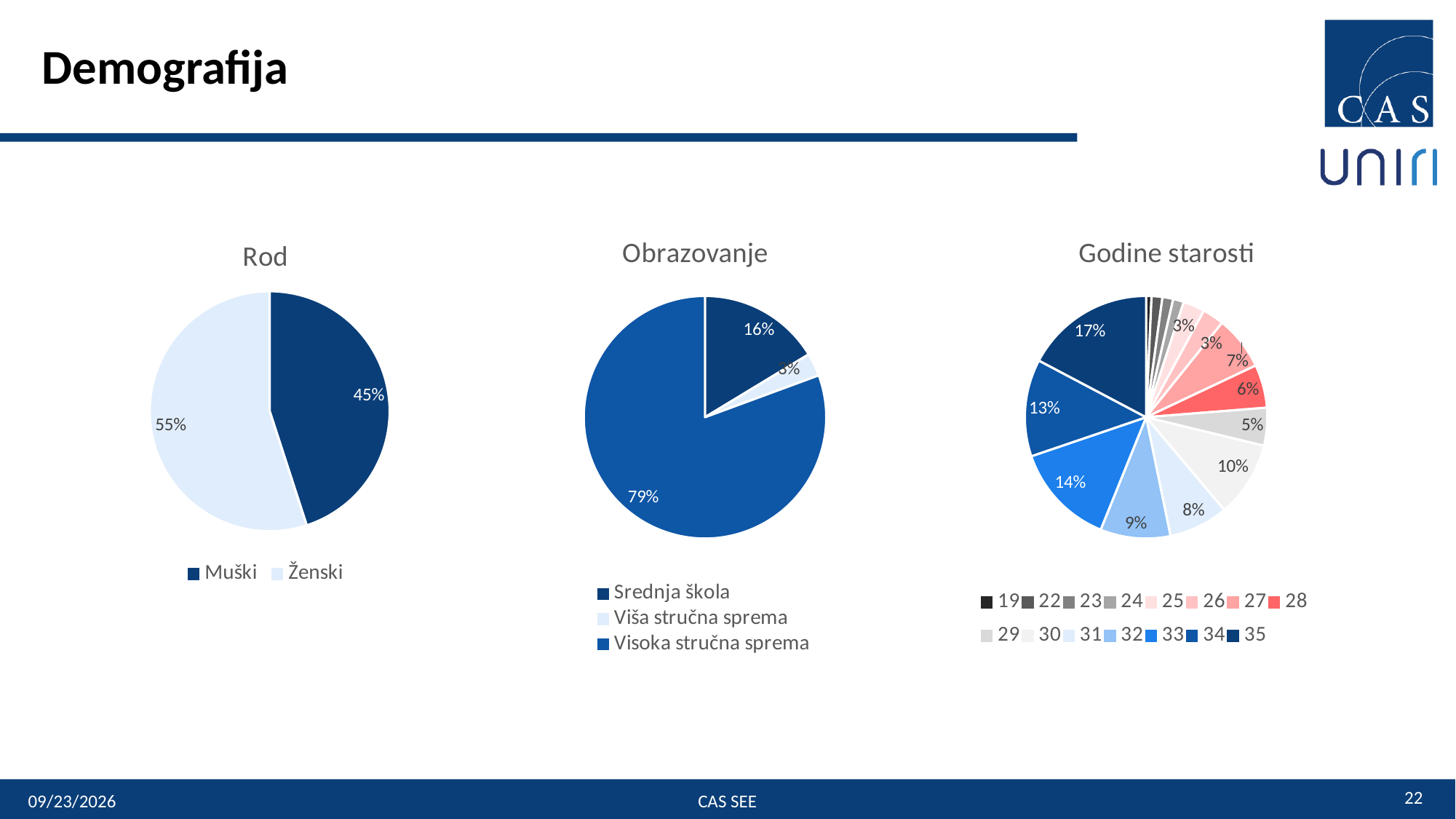
What type of chart is the Godine starosti chart? Pie chart In the Rod chart, which category has the larger share? Ženski In the Obrazovanje chart, what percentage is Visoka stručna sprema? 79% In the Obrazovanje chart, what percentage is Srednja škola? 16% In the Godine starosti chart, which age has the largest share? 35 In the Rod chart, what is the difference between the Ženski and Muški shares? 10% In the Rod chart, what percentage is Ženski? 55% In the Rod chart, what percentage is Muški? 45% In the Obrazovanje chart, which category has the smallest share? Viša stručna sprema How many categories does the legend of the Obrazovanje chart list? 3 In the Godine starosti chart, what percentage is age 35? 17% In the Godine starosti chart, what percentage is age 33? 14%